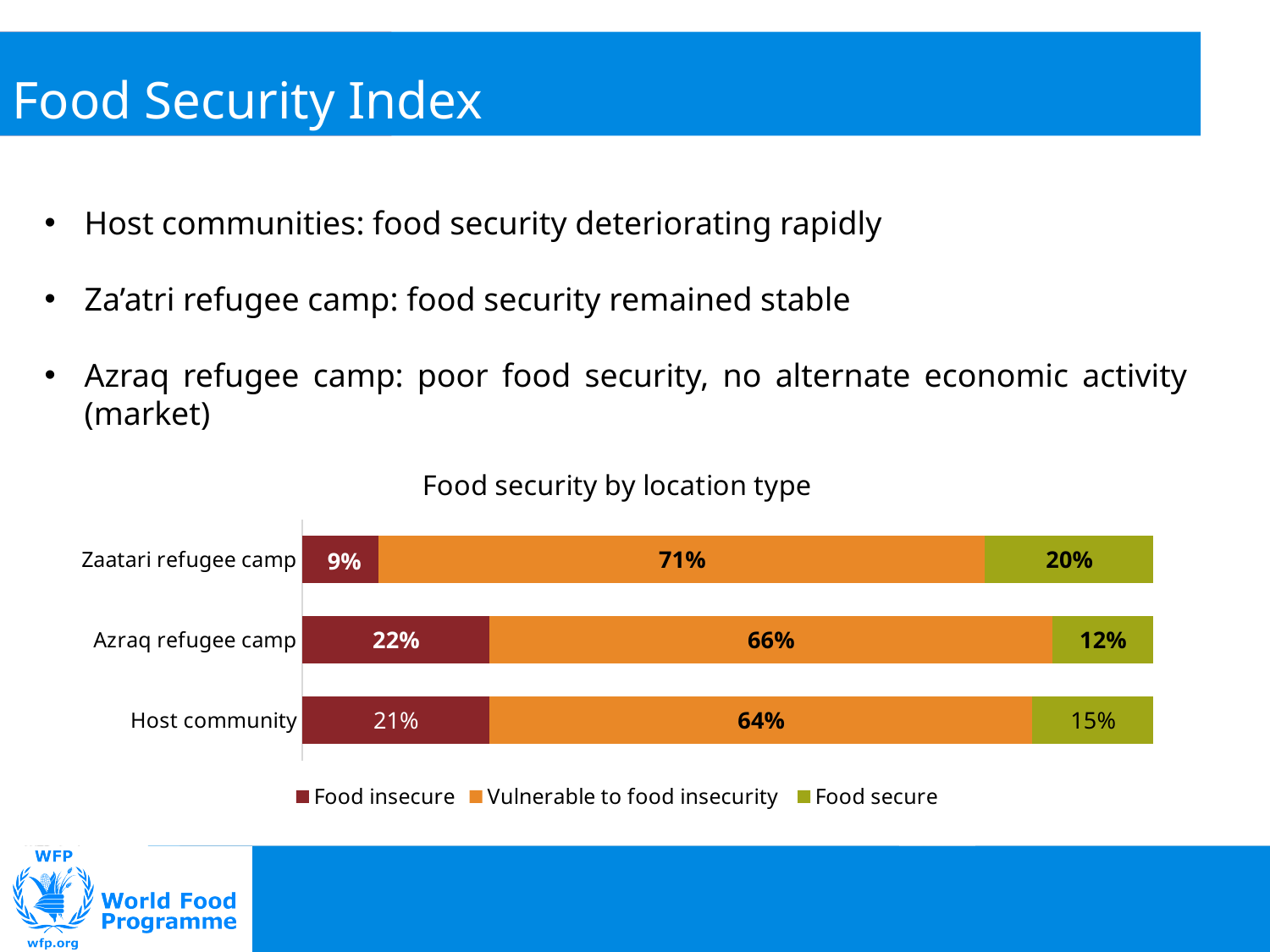
What is the Vulnerable to food insecurity value for Azraq refugee camp? 66% Which location has the lowest Food insecure share? Zaatari refugee camp What is the Food insecure value for Zaatari refugee camp? 9% What is the total of the three segments for the Azraq refugee camp bar? 100% How many series does the legend list? 3 Which location has the highest Food secure share? Zaatari refugee camp How many location categories are shown in the chart? 3 What kind of chart is shown on the slide? Stacked bar chart What is the Food secure value for Host community? 15% What is the difference between the Vulnerable to food insecurity values for Zaatari refugee camp and Host community? 7% What is the title of the chart? Food security by location type Which is larger: the Food secure value for Azraq refugee camp or for Host community? Host community